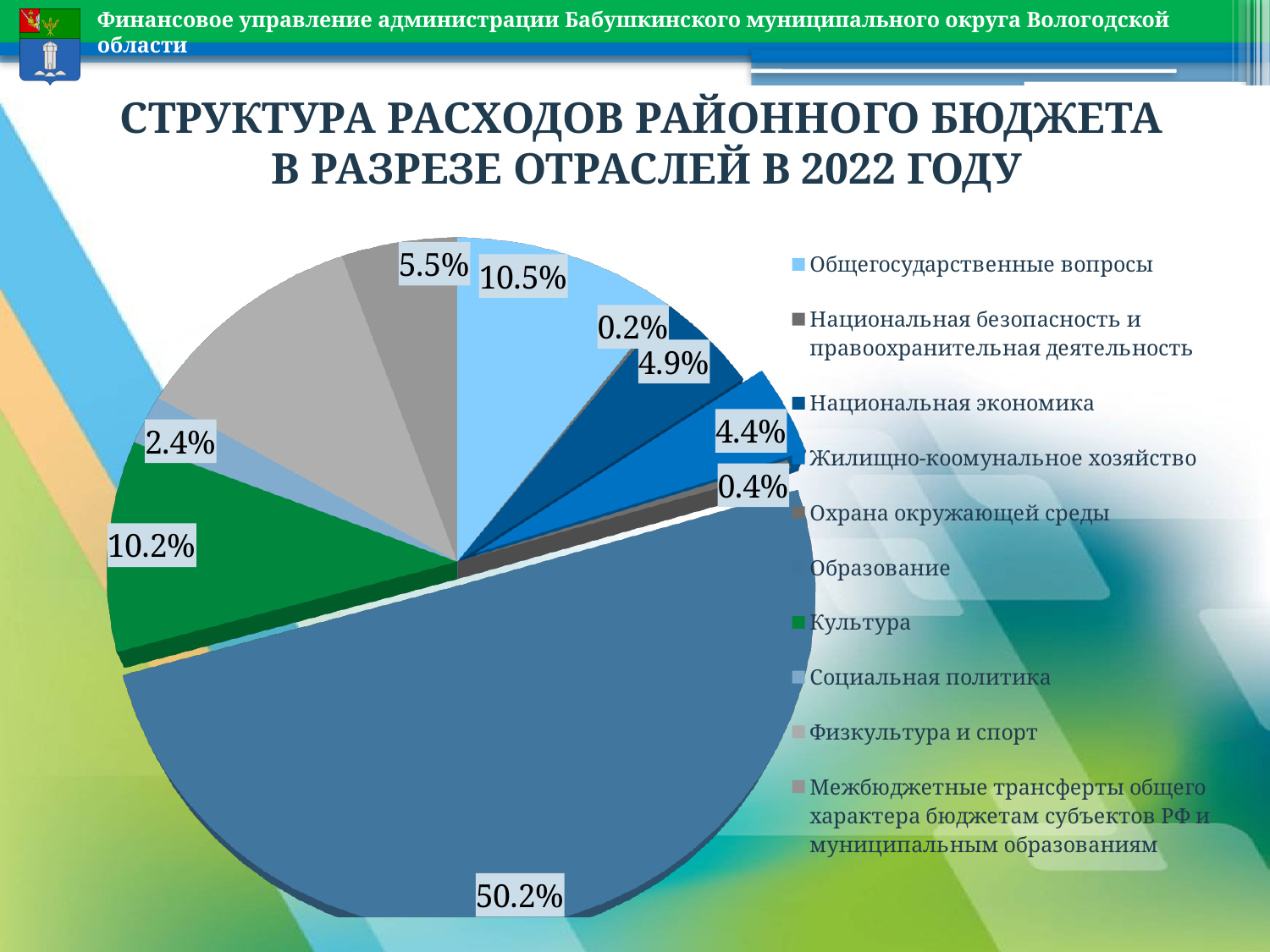
By how many percentage points does the share of Образование exceed the share of Общегосударственные вопросы? 39.7 What is the share of Культура in the pie chart? 10.2% How many categories does the legend of the pie chart list? 10 What kind of chart is shown on the slide? pie chart Which legend entry is listed first in the pie chart's legend? Общегосударственные вопросы What is the smallest percentage printed on the pie chart? 0.2% What is the share of the largest slice in the pie chart? 50.2% Which category has the largest share of the district budget expenditures? Образование What is the share of Общегосударственные вопросы in the pie chart? 10.5% What is the share of Образование in the pie chart? 50.2% What is the title of the chart on the slide? СТРУКТУРА РАСХОДОВ РАЙОННОГО БЮДЖЕТА В РАЗРЕЗЕ ОТРАСЛЕЙ В 2022 ГОДУ Which is larger: the share of Общегосударственные вопросы or the share of Культура? Общегосударственные вопросы